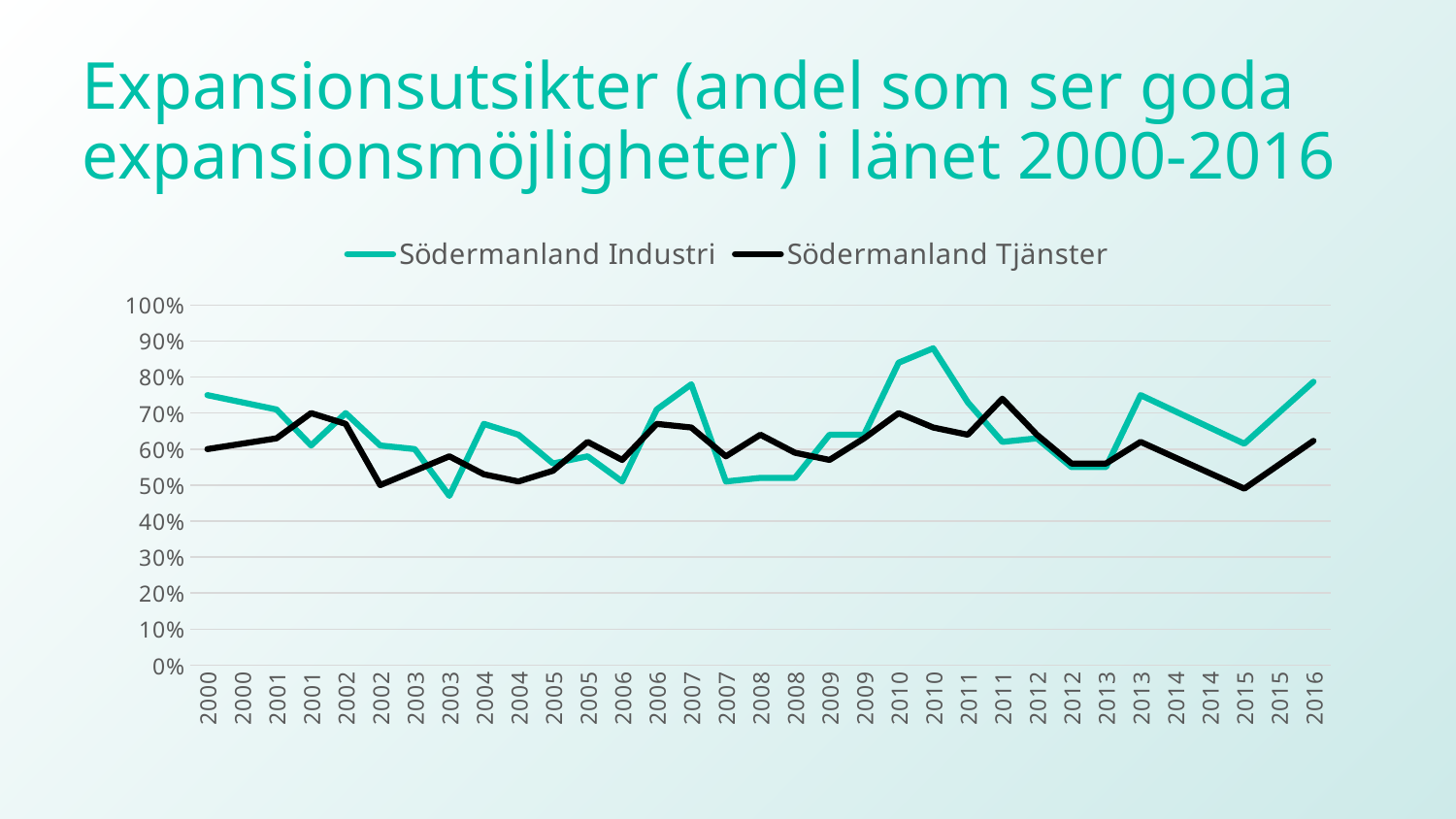
What kind of chart is shown on the slide? line chart Is the highest value for Södermanland Industri (at 2010) greater or less than 80%? greater In which year does Södermanland Industri reach its highest value? 2010 Is the lowest value for Södermanland Industri (at 2003) greater or less than 50%? less How many distinct years are labelled on the x axis? 17 What are the two series named in the legend? Södermanland Industri and Södermanland Tjänster Is the 2016 value for Södermanland Industri greater or less than 70%? greater How many series does the legend list? 2 Which series is drawn in black? Södermanland Tjänster At 2016, which series has the higher value, Södermanland Industri or Södermanland Tjänster? Södermanland Industri In which year does Södermanland Industri reach its lowest value? 2003